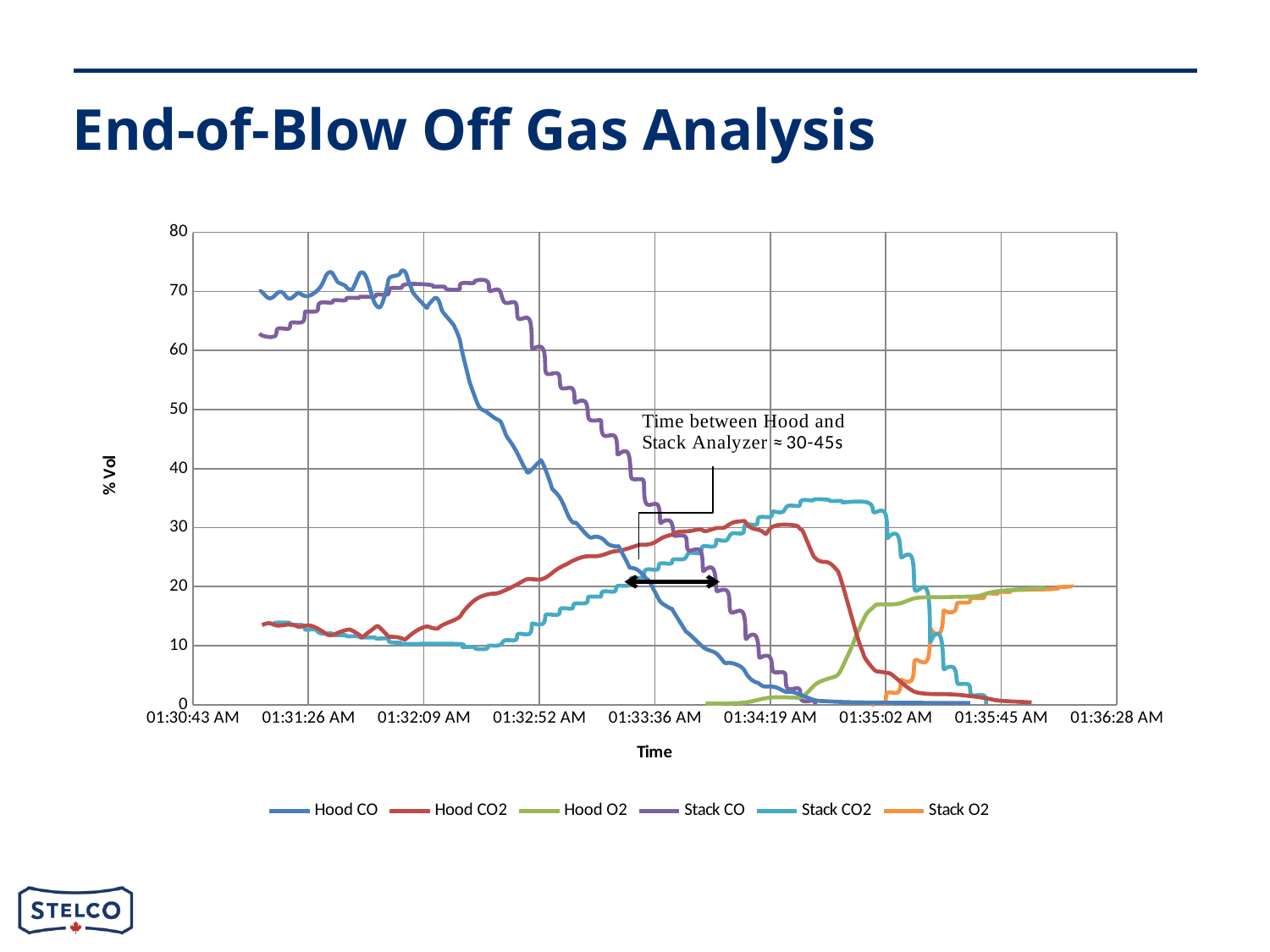
Is the value for Hood CO2 at 01:31:26 AM greater or less than 20? less At 01:35:02 AM, which is larger: Stack CO2 or Stack CO? Stack CO2 Is the value for Stack CO at 01:34:19 AM greater or less than 10? less Is the value for Hood CO at 01:31:26 AM greater or less than 60? greater Which series are listed in the legend? Hood CO, Hood CO2, Hood O2, Stack CO, Stack CO2, Stack O2 Does the Hood CO series rise or fall over time across the chart? fall How many series does the legend list? 6 At 01:32:09 AM, which is larger: Hood CO or Hood CO2? Hood CO What does the annotation on the chart say about the time between the Hood and Stack analyzers? Time between Hood and Stack Analyzer ≈ 30-45s Does the Hood O2 series rise or fall over time across the chart? rise What kind of chart is shown on the slide? line chart